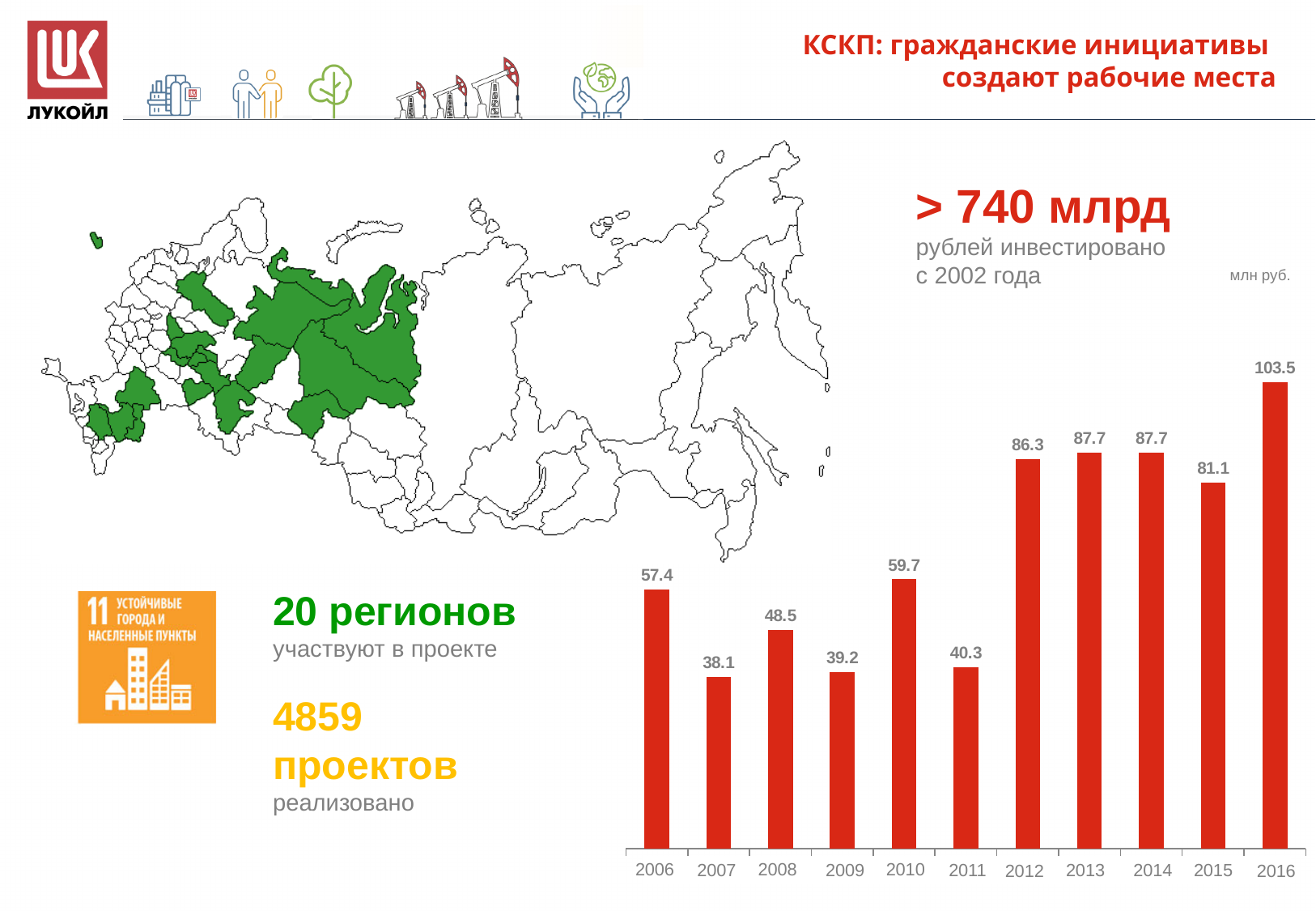
Which is larger on the bar chart, the value for 2008 or the value for 2009? 2008 What unit is indicated for the values on the bar chart? млн руб. What is the value for 2007 on the bar chart? 38.1 What is the difference between the values for 2012 and 2011 on the bar chart? 46.0 Which year has the lowest value on the bar chart? 2007 What kind of chart is shown on the slide? bar chart What is the difference between the values for 2016 and 2015 on the bar chart? 22.4 Which is larger on the bar chart, the value for 2006 or the value for 2010? 2010 What is the value for 2012 on the bar chart? 86.3 What is the value for 2016 on the bar chart? 103.5 Which year has the highest value on the bar chart? 2016 How many years are shown on the bar chart? 11